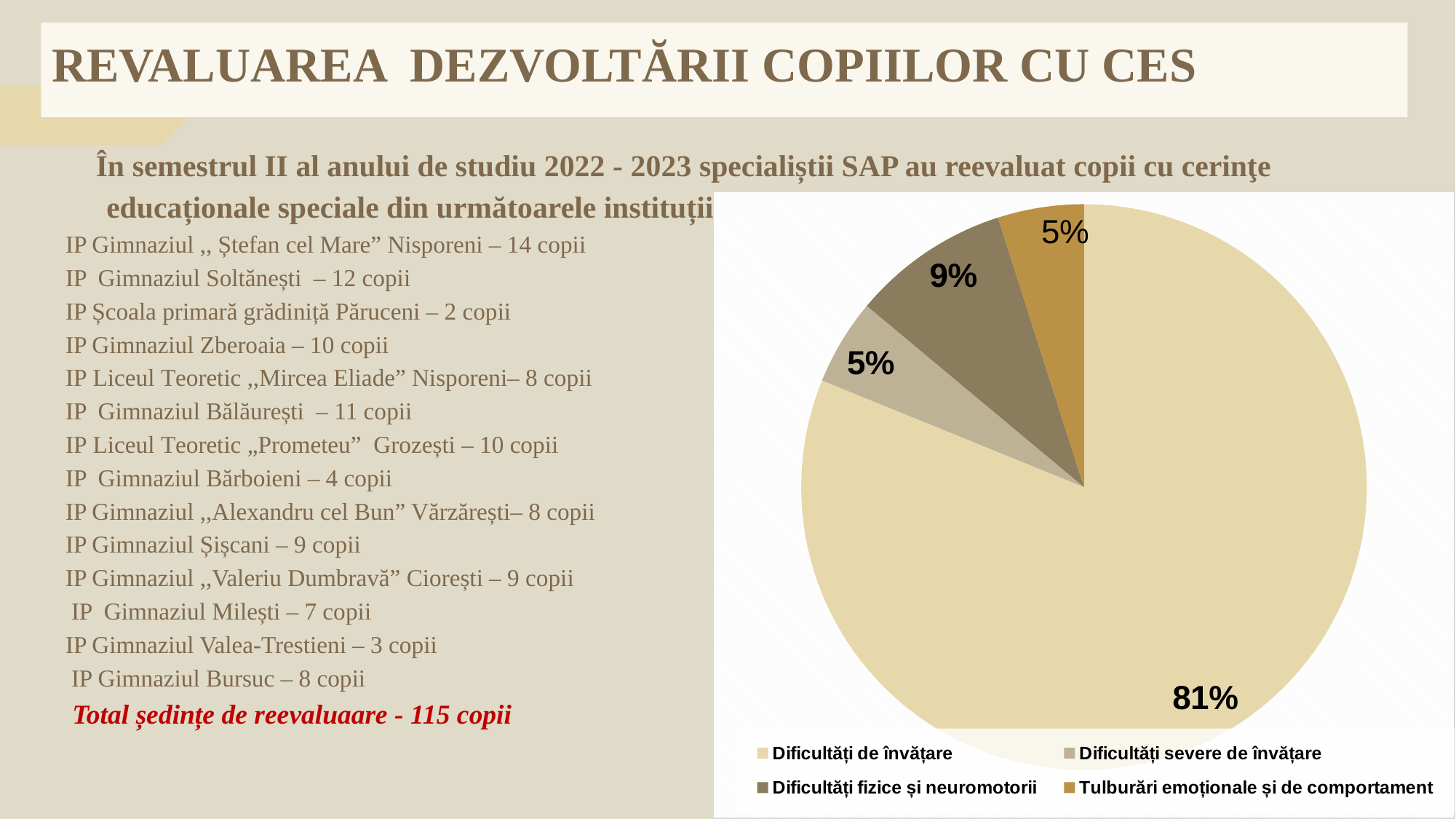
Which legend entry is shown in the darkest brown colour in the pie chart? Dificultăți fizice și neuromotorii What type of chart is shown on the slide? pie chart What percentage of the pie chart is Dificultăți fizice și neuromotorii? 9% What percentage of the pie chart is Tulburări emoționale și de comportament? 5% What share of the pie does the largest slice represent? 81% What percentage of the pie chart is Dificultăți severe de învățare? 5% What percentage of the pie chart is Dificultăți de învățare? 81% Which category has the largest slice of the pie chart? Dificultăți de învățare Which is larger in the pie chart: Dificultăți fizice și neuromotorii or Dificultăți severe de învățare? Dificultăți fizice și neuromotorii How many entries does the legend of the pie chart list? 4 What is the difference in percentage points between Dificultăți de învățare and Dificultăți fizice și neuromotorii? 72 How many slices does the pie chart have? 4